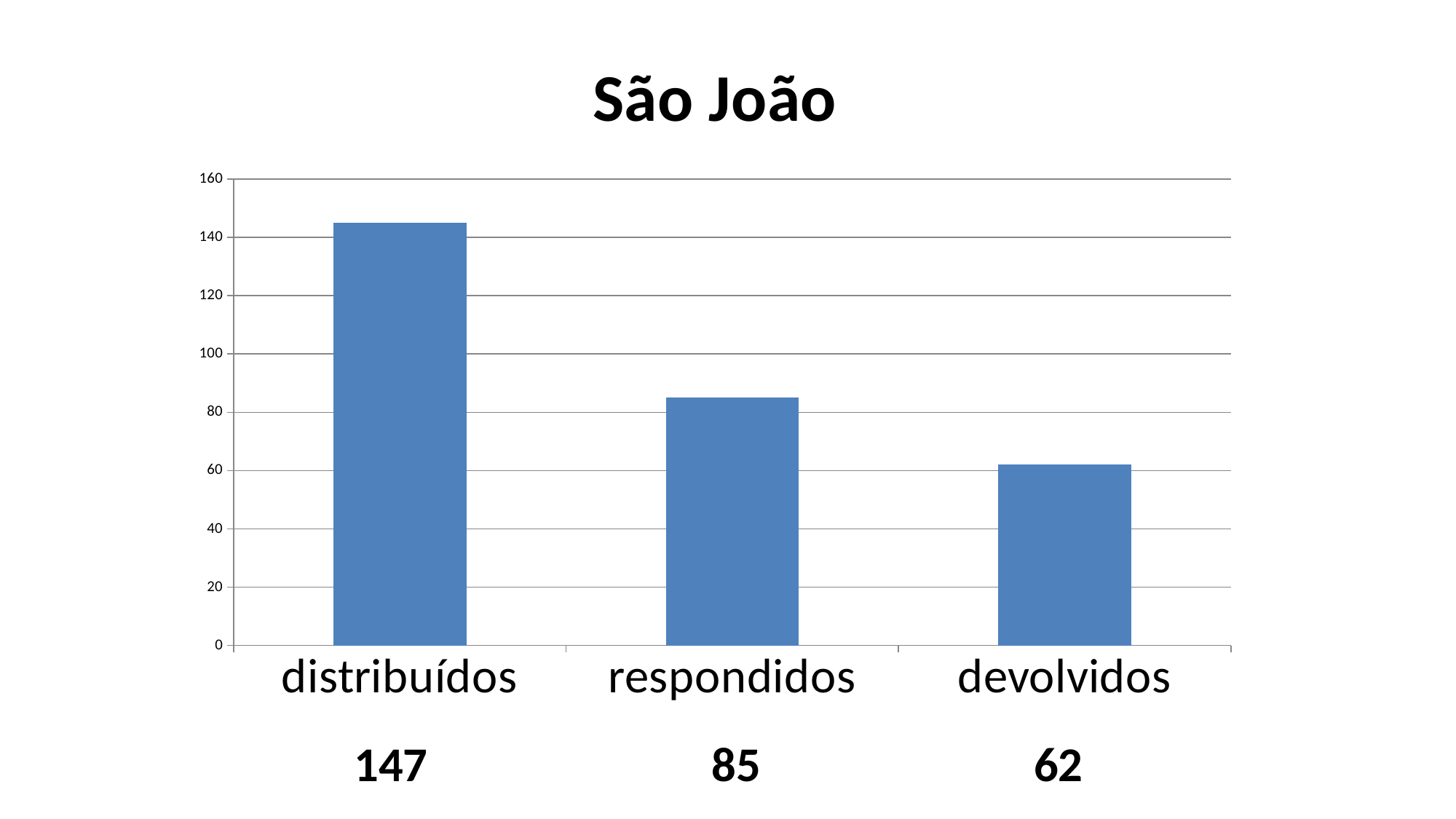
What kind of chart is shown on the slide? bar chart Which category has the highest value? distribuídos Is the value for distribuídos greater or less than 120? greater Which is larger, the value for respondidos or the value for devolvidos? respondidos How many categories are shown on the chart? 3 What is the value for respondidos? 85 What is the difference between the values for respondidos and devolvidos? 23 What is the title of the chart? São João Which category has the lowest value? devolvidos What is the value for devolvidos? 62